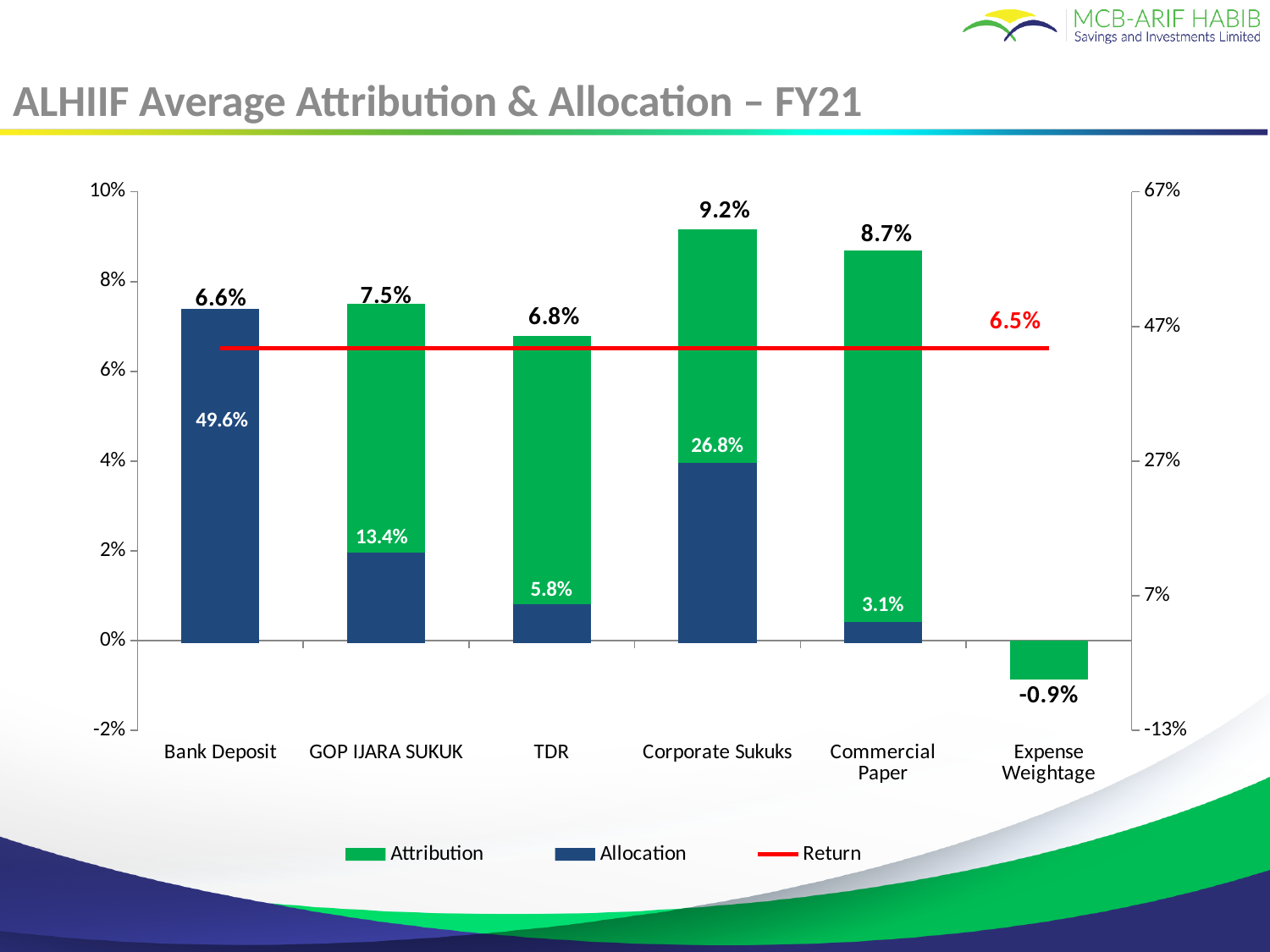
What is the Attribution value for Corporate Sukuks? 9.2% How many categories are shown on the x axis? 6 Which category has the highest Attribution value? Corporate Sukuks What is the Allocation value for Bank Deposit? 49.6% What is the title of the chart? ALHIIF Average Attribution & Allocation – FY21 What value is shown for the Return line? 6.5% What is the difference between the Attribution values for Corporate Sukuks and Commercial Paper? 0.5% Which category has the highest Allocation value? Bank Deposit Which has a higher Attribution value, GOP IJARA SUKUK or TDR? GOP IJARA SUKUK Which category has the lowest Attribution value? Expense Weightage Which category has the lowest labelled Allocation value? Commercial Paper How many series does the legend list? 3